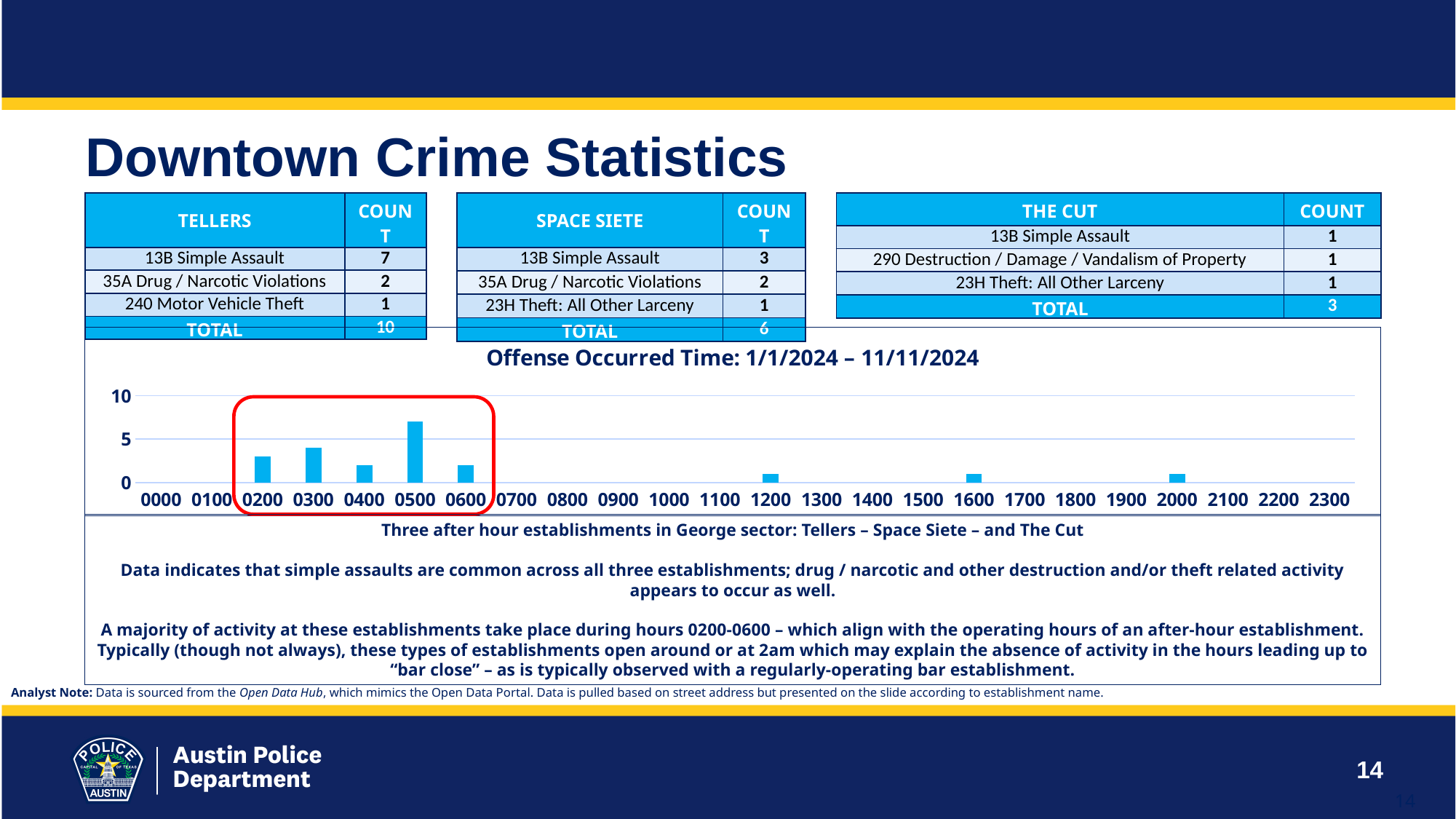
What is the title of the chart on the slide? Offense Occurred Time: 1/1/2024 – 11/11/2024 Which hour has the highest bar in the chart? 0500 Is the value for 0500 greater or less than 10? less Is the value for 0500 greater or less than 5? greater Is the value for 1200 greater or less than 5? less How many hour categories are shown along the x axis of the chart? 24 Which is larger, the value for 0500 or the value for 0300? 0500 How many hours on the chart have a visible bar above zero? 8 Which is larger, the value for 0300 or the value for 0400? 0300 What kind of chart is shown under the title "Offense Occurred Time: 1/1/2024 – 11/11/2024"? Bar chart